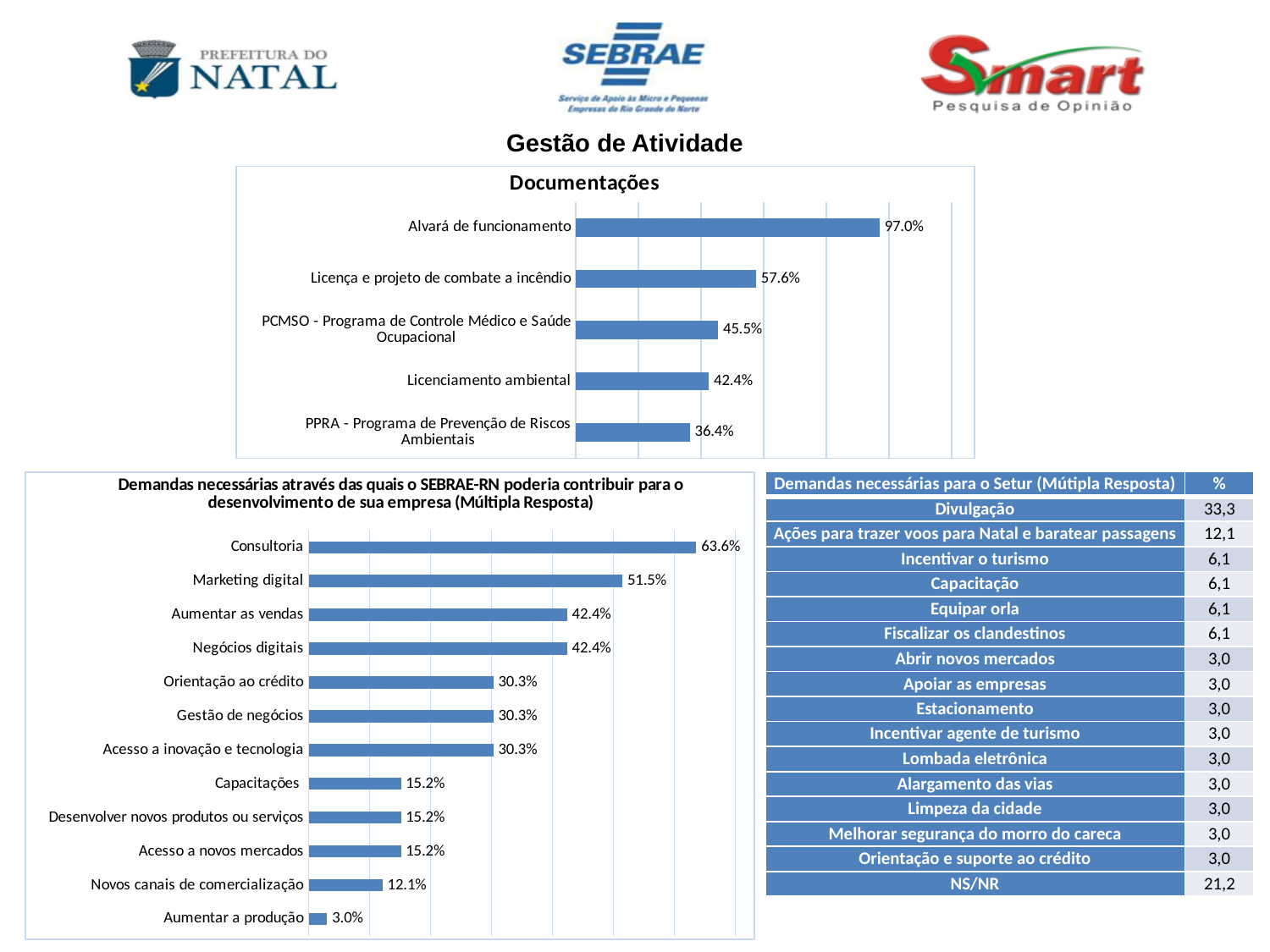
In the "Demandas necessárias através das quais o SEBRAE-RN poderia contribuir" chart, which category has the highest value? Consultoria In the "Demandas necessárias através das quais o SEBRAE-RN poderia contribuir" chart, which is larger: Orientação ao crédito or Capacitações? Orientação ao crédito In the "Demandas necessárias através das quais o SEBRAE-RN poderia contribuir" chart, which category has the lowest value? Aumentar a produção In the "Documentações" chart, what is the difference between Licença e projeto de combate a incêndio and Licenciamento ambiental? 15.2% In the "Documentações" chart, what is the value for Alvará de funcionamento? 97.0% In the "Documentações" chart, which category has the lowest value? PPRA - Programa de Prevenção de Riscos Ambientais In the "Documentações" chart, what is the value for PCMSO - Programa de Controle Médico e Saúde Ocupacional? 45.5% What kind of chart is the "Documentações" chart? Bar chart In the "Demandas necessárias através das quais o SEBRAE-RN poderia contribuir" chart, how many categories are plotted? 12 In the "Demandas necessárias através das quais o SEBRAE-RN poderia contribuir" chart, what is the value for Marketing digital? 51.5% In the "Demandas necessárias através das quais o SEBRAE-RN poderia contribuir" chart, what is the difference between Consultoria and Novos canais de comercialização? 51.5% In the "Documentações" chart, how many categories are plotted? 5